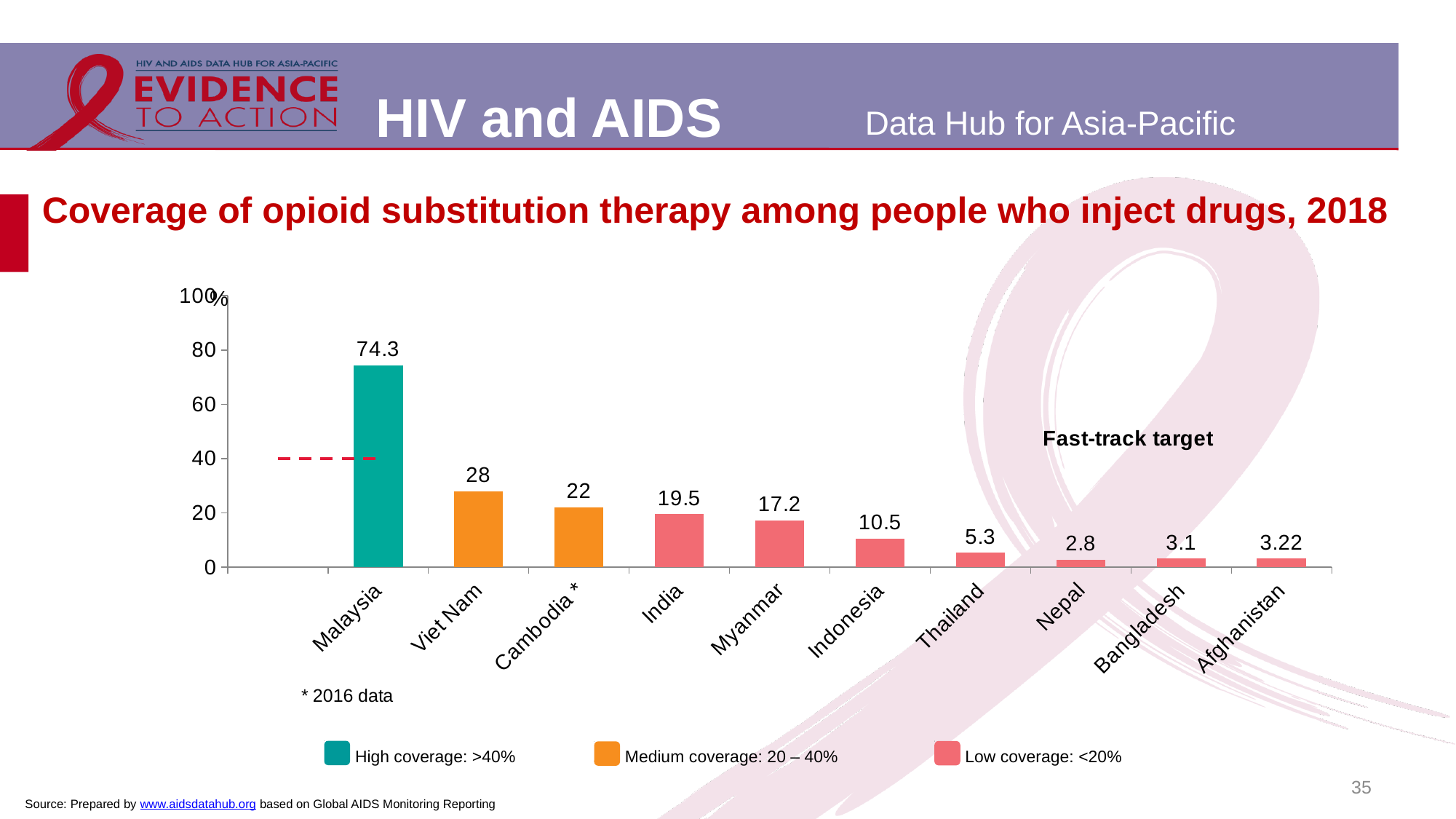
Which country has the highest coverage of opioid substitution therapy? Malaysia How many countries are shown on the chart? 10 What is the difference between the values for Malaysia and Viet Nam? 46.3 Which country has the lowest coverage of opioid substitution therapy? Nepal What kind of chart is shown on the slide? Bar chart What is the value shown for Afghanistan? 3.22 What is the value shown for Indonesia? 10.5 What does the dashed red line on the chart represent? Fast-track target Which has a higher value, India or Myanmar? India Is the value for Cambodia greater or less than 40? less What is the coverage of opioid substitution therapy for Malaysia? 74.3 What is the value shown for Viet Nam? 28